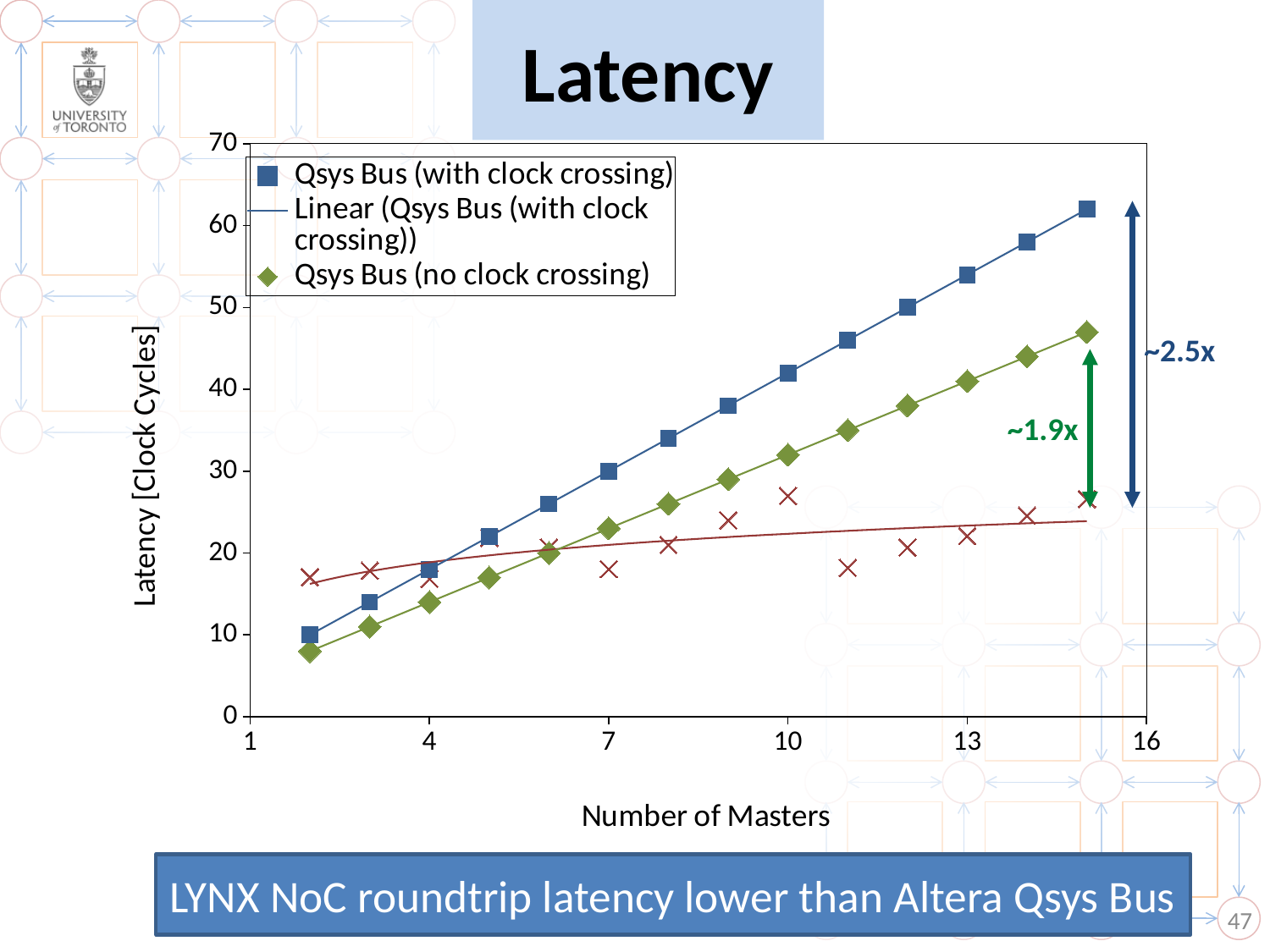
Is the latency for Qsys Bus (with clock crossing) at 4 masters greater or less than 20? less Which series reaches the highest latency at the right end of the chart? Qsys Bus (with clock crossing) Is the latency for Qsys Bus (with clock crossing) at 13 masters greater or less than 50? greater How many series does the legend list? 3 What is the label of the y axis? Latency [Clock Cycles] Does the latency of the Qsys Bus (no clock crossing) series rise or fall along the x axis? rise What is the title of the chart? Latency At 13 masters, which series has the higher latency: Qsys Bus (with clock crossing) or Qsys Bus (no clock crossing)? Qsys Bus (with clock crossing) Is the latency for Qsys Bus (no clock crossing) at 4 masters greater or less than 10? greater Does the latency of the Qsys Bus (with clock crossing) series rise or fall as the number of masters increases? rise